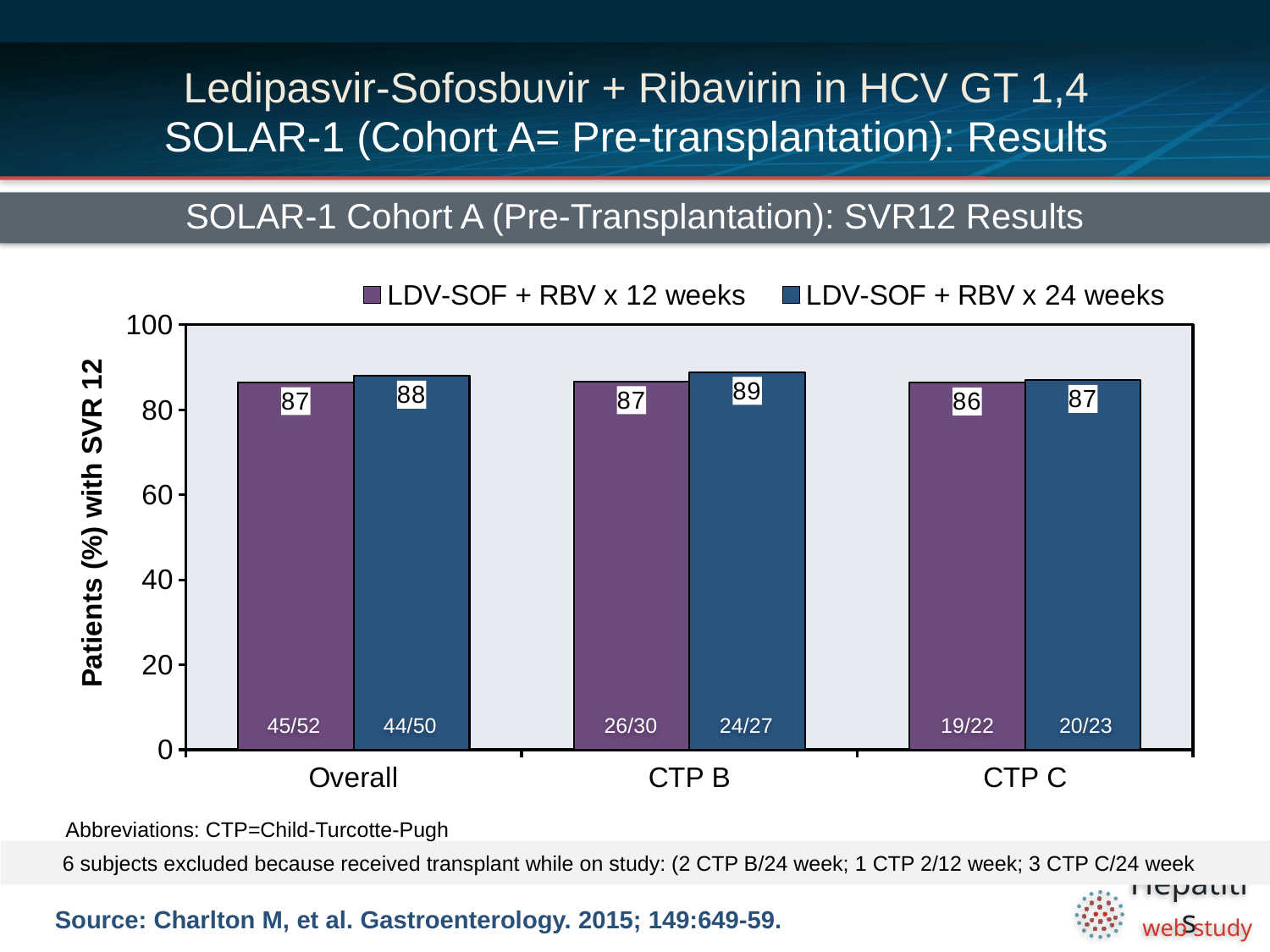
What kind of chart is shown on the slide? Bar chart How many categories are shown on the x axis? 3 What is the SVR12 rate for CTP B with LDV-SOF + RBV x 24 weeks? 89 For CTP C, which regimen has the higher SVR12 rate, 12 weeks or 24 weeks? LDV-SOF + RBV x 24 weeks What is the SVR12 rate for the Overall group with LDV-SOF + RBV x 12 weeks? 87 What fraction of patients is shown for the Overall group with LDV-SOF + RBV x 24 weeks? 44/50 What is the SVR12 rate for CTP C with LDV-SOF + RBV x 12 weeks? 86 Which category has the lowest SVR12 rate for LDV-SOF + RBV x 12 weeks? CTP C What is the difference between the 24-week and 12-week SVR12 rates for CTP B? 2 What fraction of patients is shown for CTP C with LDV-SOF + RBV x 12 weeks? 19/22 Which category has the highest SVR12 rate for LDV-SOF + RBV x 24 weeks? CTP B How many series does the legend list? 2